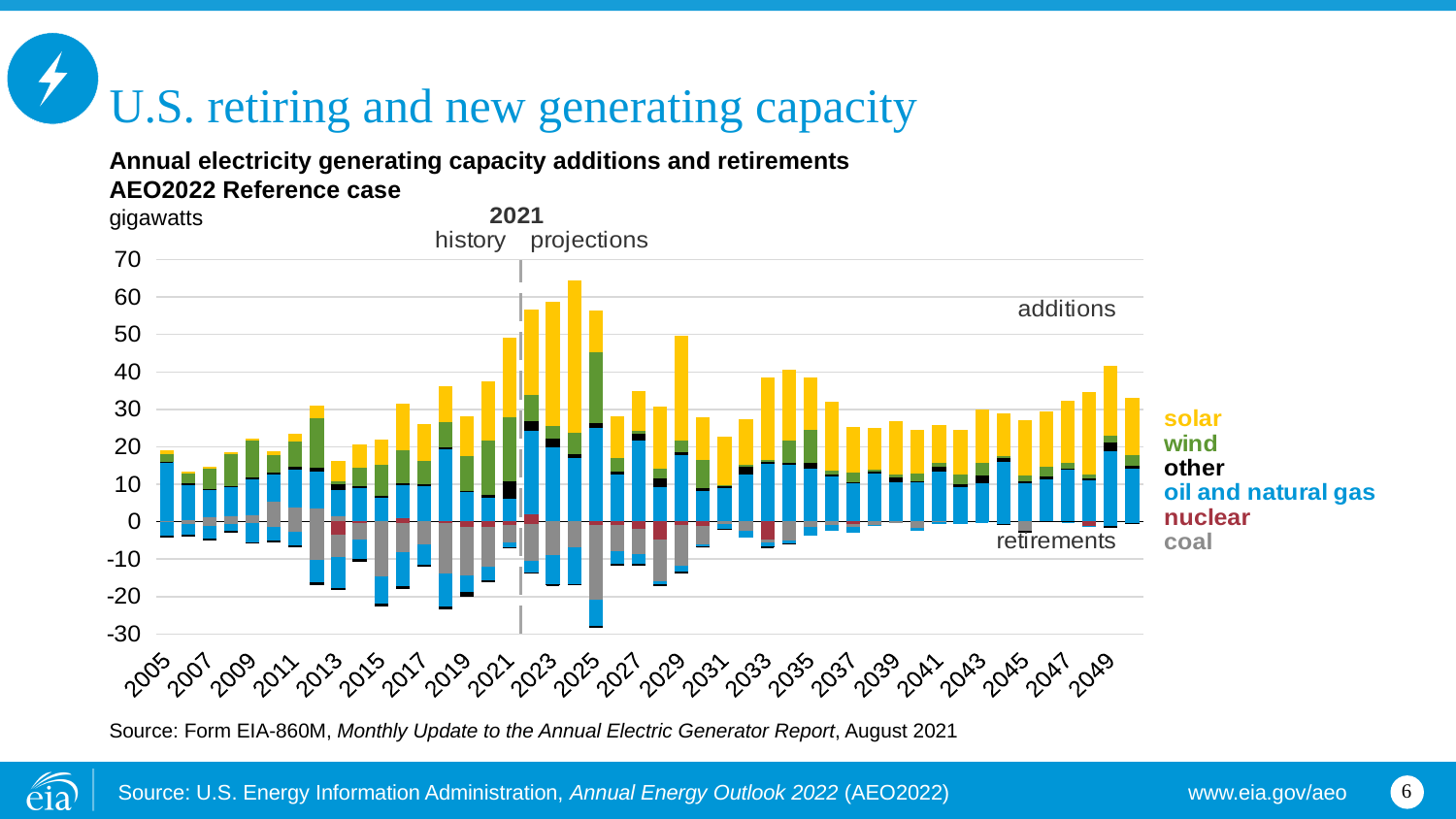
Do total additions rise or fall from 2021 to 2024? rise Which year does the dashed vertical line separating history from projections mark? 2021 How many series does the legend list? 6 Are the total additions for 2040 greater or less than 30 gigawatts? less What kind of chart is shown on the slide? stacked bar chart What unit is used on the y axis of the chart? gigawatts Are the total additions for 2022 greater or less than 50 gigawatts? greater How many years are shown on the x axis? 46 Which year has the highest total capacity additions? 2024 Are the total additions for 2024 greater or less than 60 gigawatts? greater Which year has larger total additions, 2028 or 2030? 2028